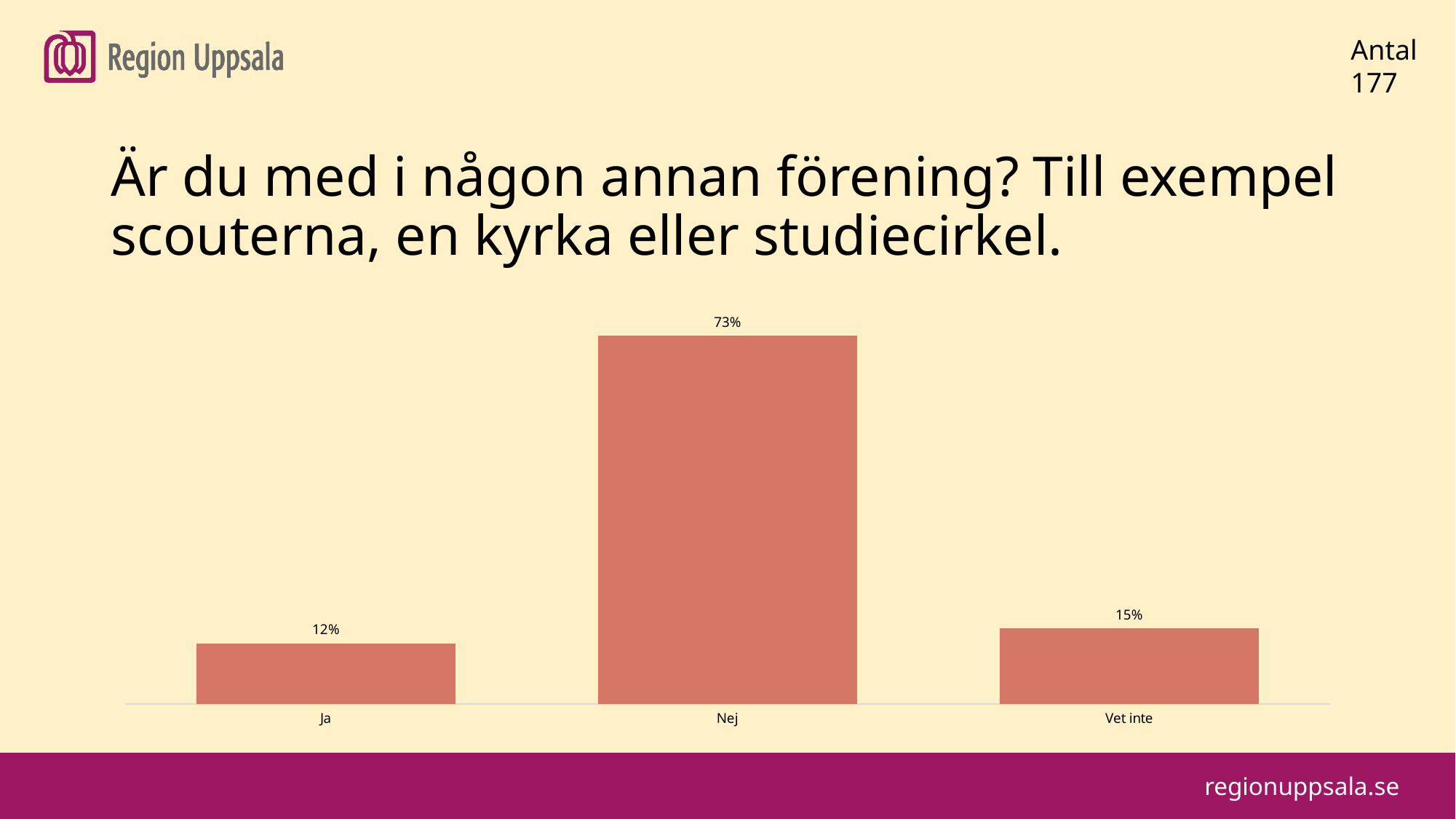
What colour are the bars in the chart? Red/salmon Which category has the highest value? Nej What is the value for Ja? 12% What is the value for Nej? 73% What kind of chart is shown on the slide? Bar chart What is the difference between the values for Nej and Vet inte? 58% What is the value for Vet inte? 15% What is the difference between the values for Vet inte and Ja? 3% How many categories are shown in the chart? 3 What is the number of respondents (Antal) shown on the slide? 177 Which is larger, the value for Ja or the value for Vet inte? Vet inte Which category has the lowest value? Ja